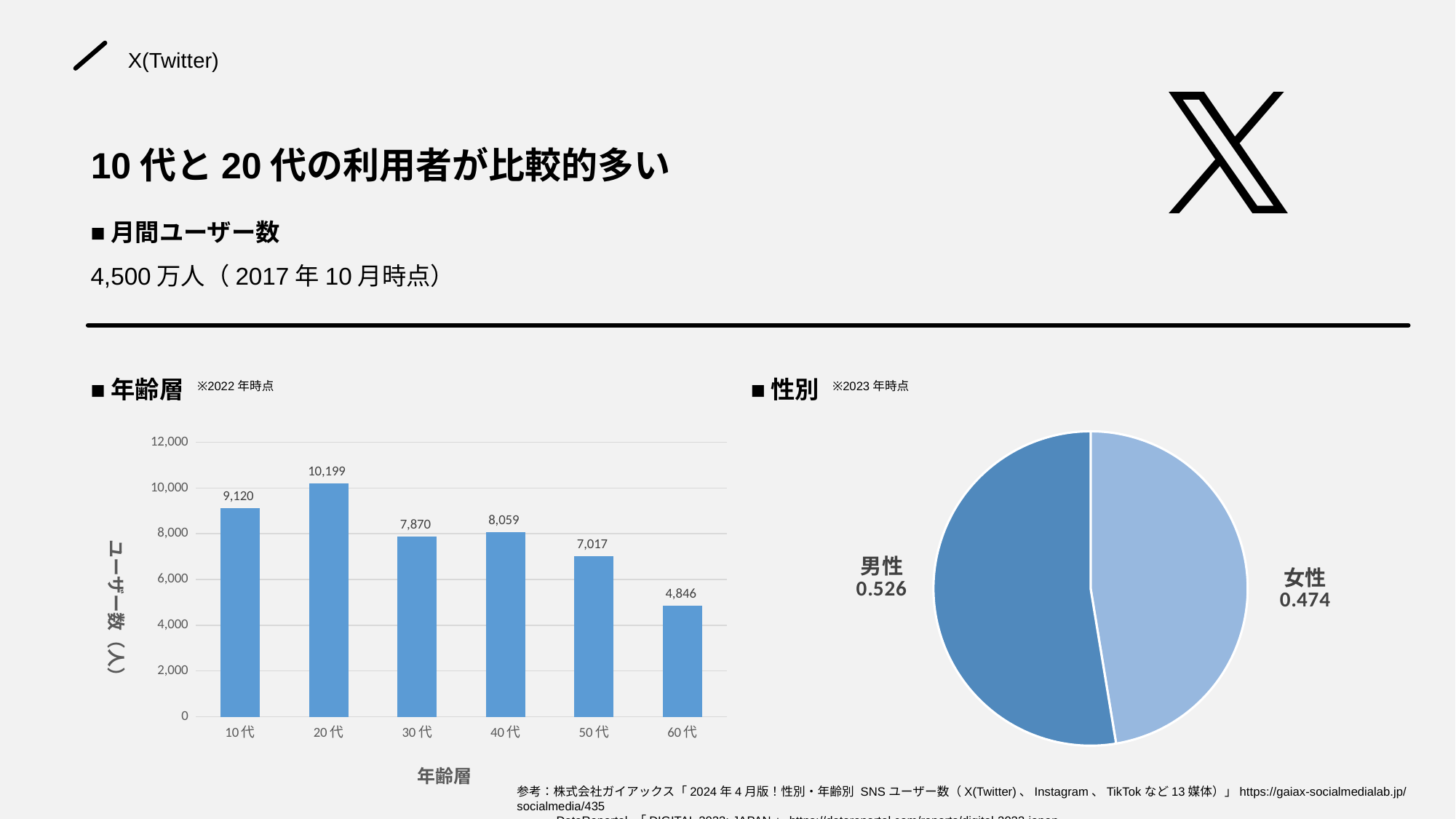
In the 年齢層 bar chart, which age group has the highest number of users? 20代 In the 性別 pie chart, which is larger, 男性 or 女性? 男性 In the 年齢層 bar chart, what is the value for 20代? 10,199 In the 年齢層 bar chart, is the value for 50代 greater or less than 8,000? less In the 年齢層 bar chart, which age group has the lowest number of users? 60代 In the 年齢層 bar chart, which is larger, the value for 30代 or 40代? 40代 How many age groups are shown in the 年齢層 bar chart? 6 In the 年齢層 bar chart, what is the value for 60代? 4,846 In the 年齢層 bar chart, what is the difference between the values for 20代 and 10代? 1,079 In the 性別 pie chart, what is the share for 男性? 0.526 What is the y-axis label of the 年齢層 bar chart? ユーザー数（人） What kind of chart is the 年齢層 chart? bar chart